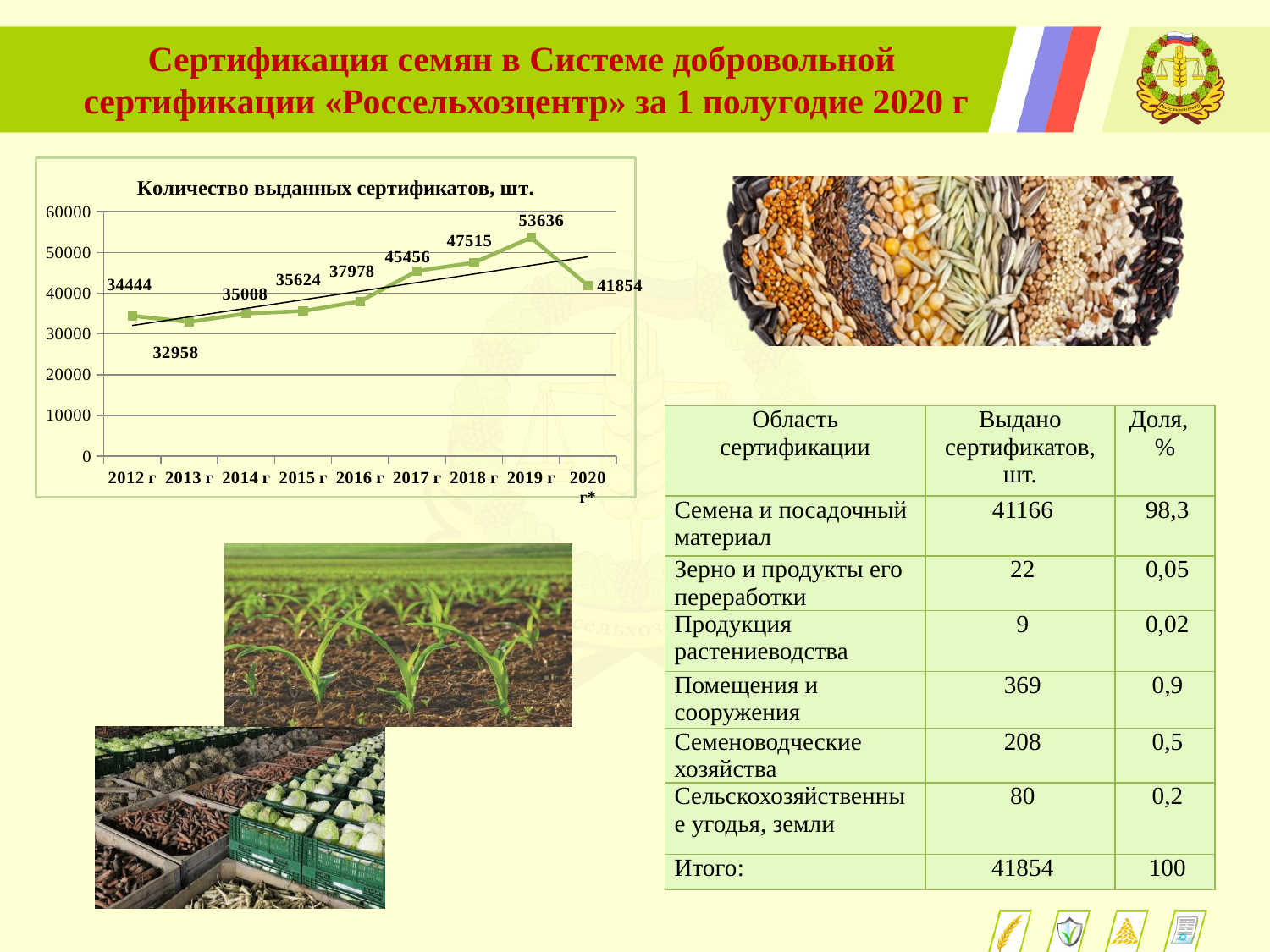
What is the value for 2020 г* in the chart? 41854 How many years are plotted on the x axis of the chart? 9 What is the difference between the values for 2019 г and 2020 г* in the chart? 11782 Which is larger in the chart, the value for 2017 г or the value for 2018 г? 2018 г What is the value for 2012 г in the chart? 34444 Which year has the lowest value in the chart? 2013 г Is the value for 2013 г in the chart greater or less than 40000? less What is the value for 2019 г in the chart? 53636 Which year has the highest value in the chart? 2019 г What is the title of the chart on the slide? Количество выданных сертификатов, шт. What type of chart is shown on the slide? line chart What is the value for 2016 г in the chart? 37978